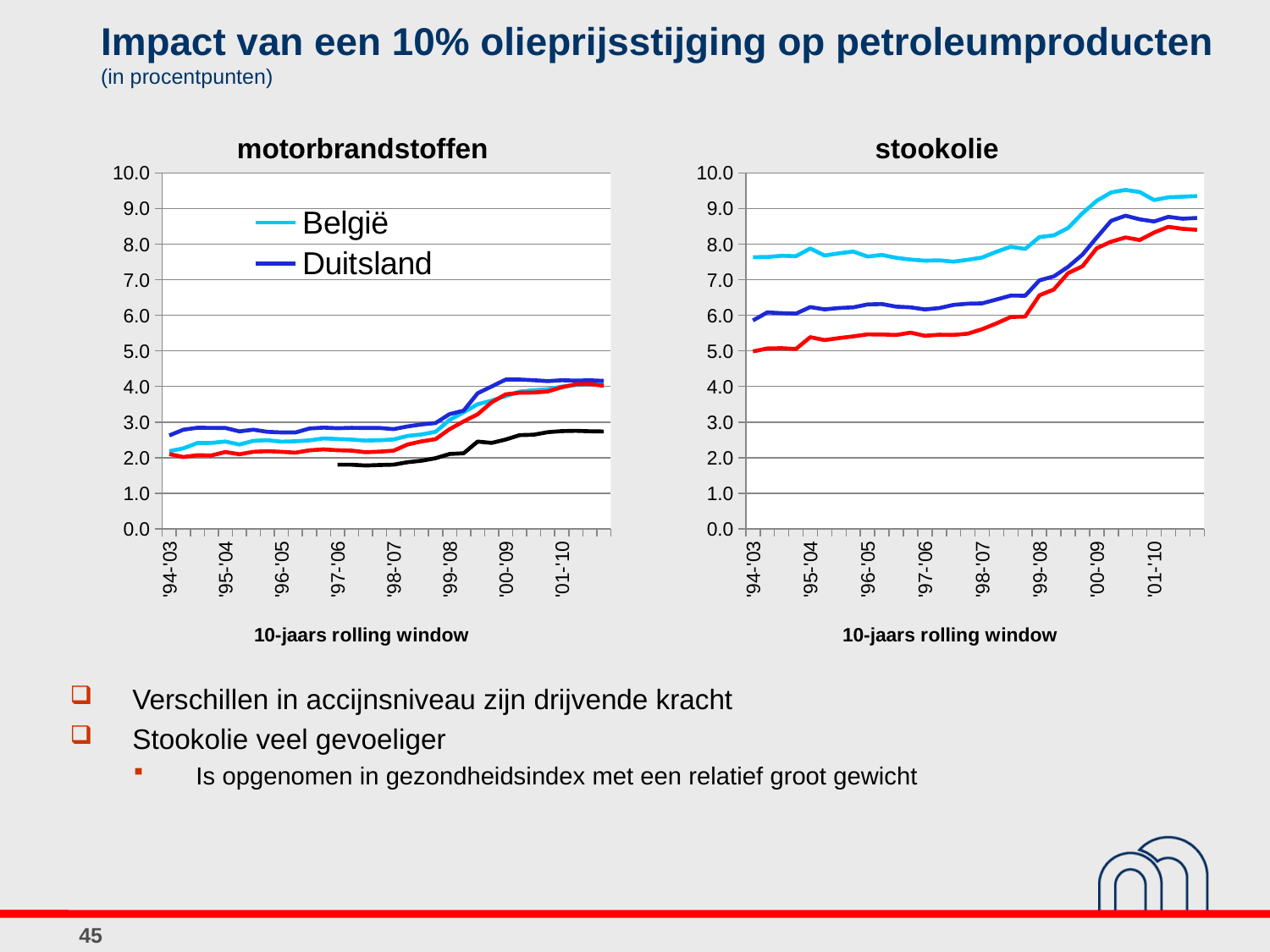
In the 'motorbrandstoffen' chart, which is higher at '94-'03: België or Duitsland? Duitsland What type of chart is the 'stookolie' chart? line chart In the 'motorbrandstoffen' chart, does the Duitsland line rise or fall from '94-'03 to '01-'10? rise In the 'stookolie' chart, is the value for Duitsland at '94-'03 greater or less than 7.0? less In the 'stookolie' chart, does the België line rise or fall from '94-'03 to '01-'10? rise In the 'motorbrandstoffen' chart, is the value for Duitsland at '94-'03 greater or less than 2.0? greater In the 'stookolie' chart, which is higher at '94-'03: België or Duitsland? België How many series does the legend on the 'motorbrandstoffen' chart list? 2 In the 'motorbrandstoffen' chart, which series is shown in light blue? België What type of chart is the 'motorbrandstoffen' chart? line chart What is the x-axis label shown under the 'stookolie' chart? 10-jaars rolling window In the 'stookolie' chart, is the value for België at '94-'03 greater or less than 7.0? greater